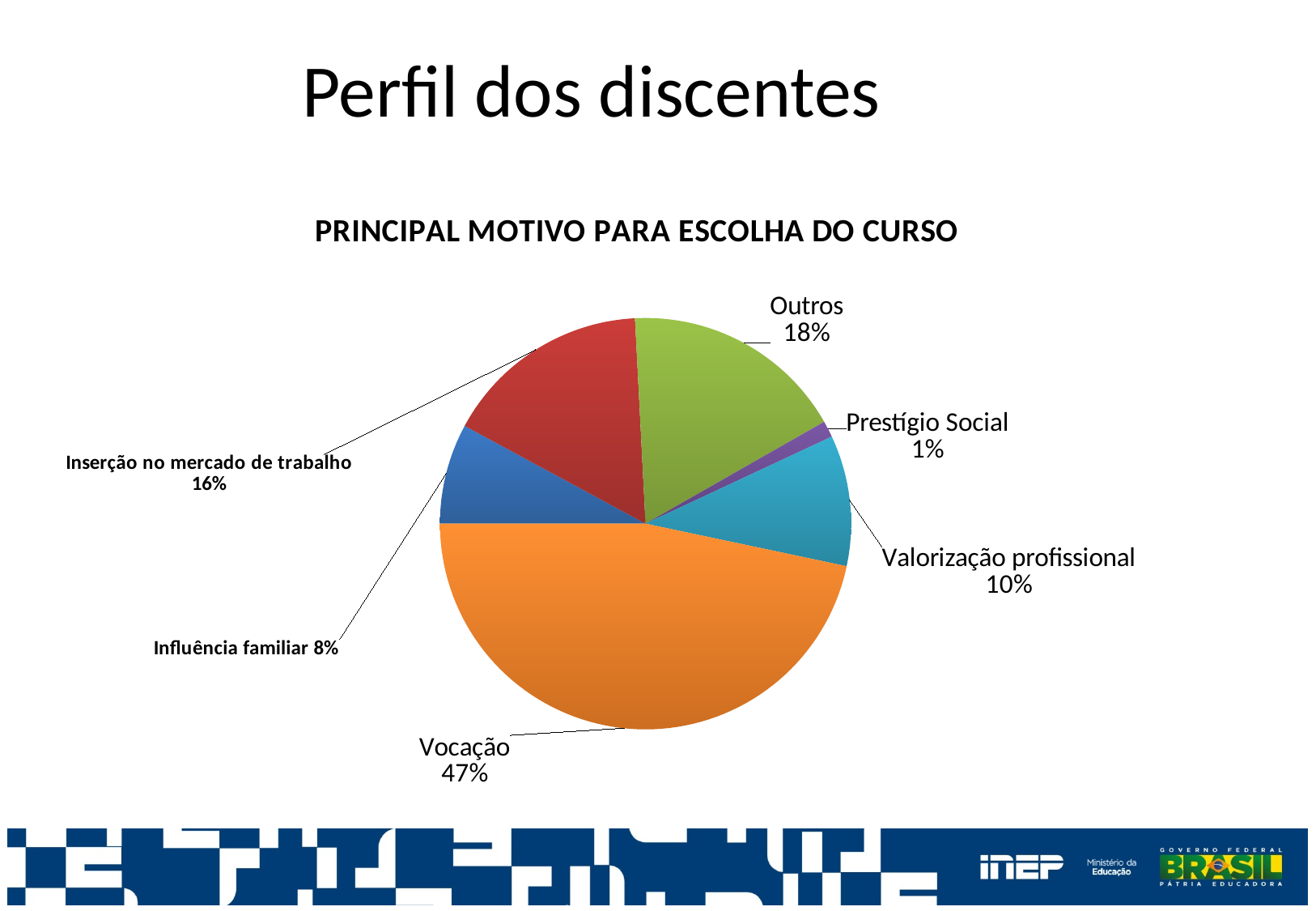
What is the title of the chart? PRINCIPAL MOTIVO PARA ESCOLHA DO CURSO Which category has the largest slice of the pie? Vocação What is the value shown for Outros? 18% What share of the pie does Vocação represent? 47% What is the value shown for Influência familiar? 8% What is the value shown for Valorização profissional? 10% What kind of chart is shown on the slide? Pie chart Which is larger, the share for Outros or the share for Inserção no mercado de trabalho? Outros How many categories are shown in the pie chart? 6 Which category has the smallest slice of the pie? Prestígio Social What is the value shown for Inserção no mercado de trabalho? 16% What is the difference between the shares of Vocação and Outros? 29%